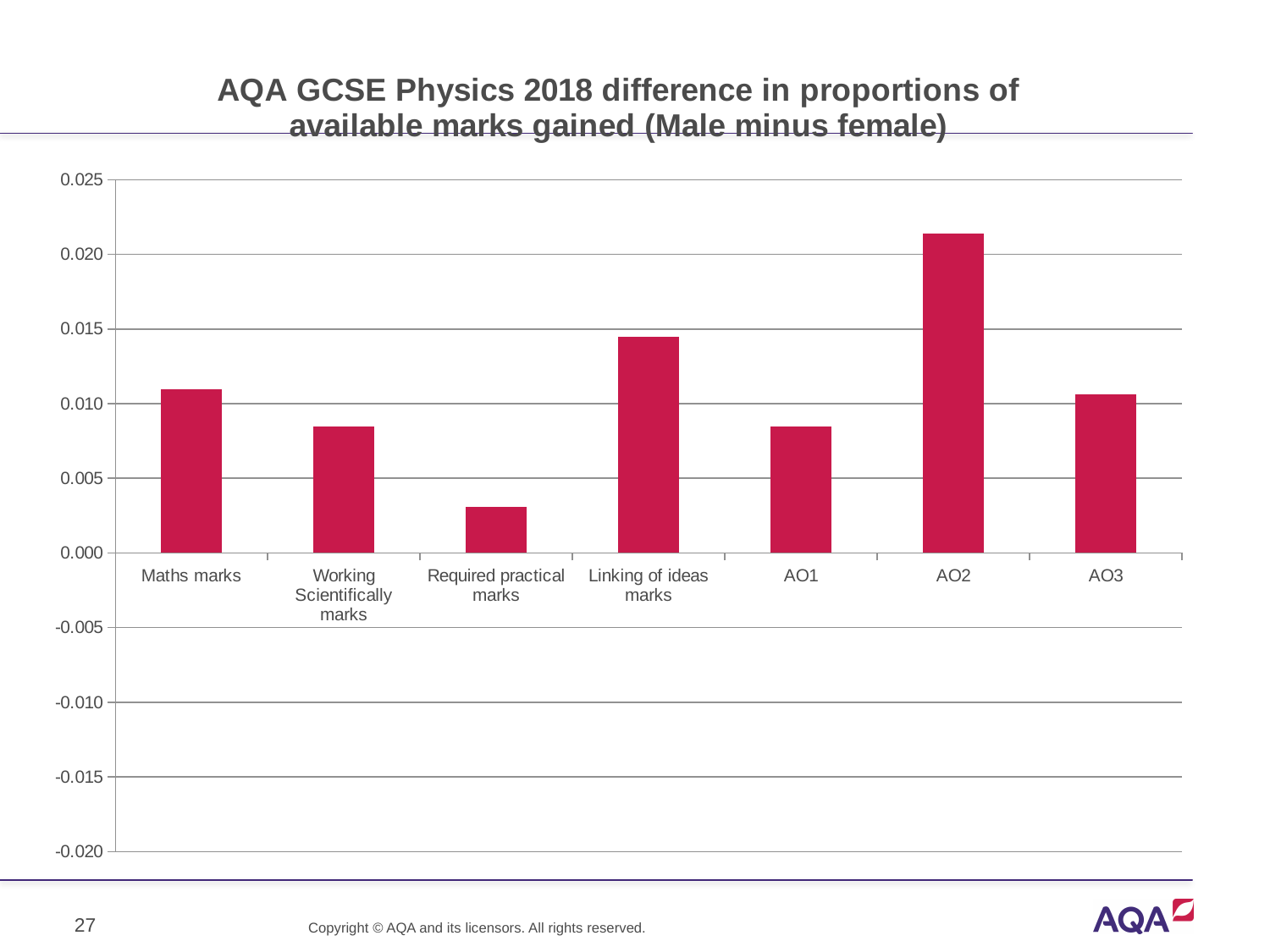
How many categories are plotted on the x axis? 7 Which category has the lowest value? Required practical marks What is the title of the chart? AQA GCSE Physics 2018 difference in proportions of available marks gained (Male minus female) Is the value for Linking of ideas marks greater or less than 0.010? greater Which is larger, the value for Linking of ideas marks or the value for Maths marks? Linking of ideas marks Is the value for AO2 greater or less than 0.020? greater Which is larger, the value for Required practical marks or the value for AO1? AO1 Is the value for AO1 greater or less than 0.010? less Which is larger, the value for AO2 or the value for Linking of ideas marks? AO2 Which category has the highest value? AO2 What kind of chart is shown on the slide? bar chart